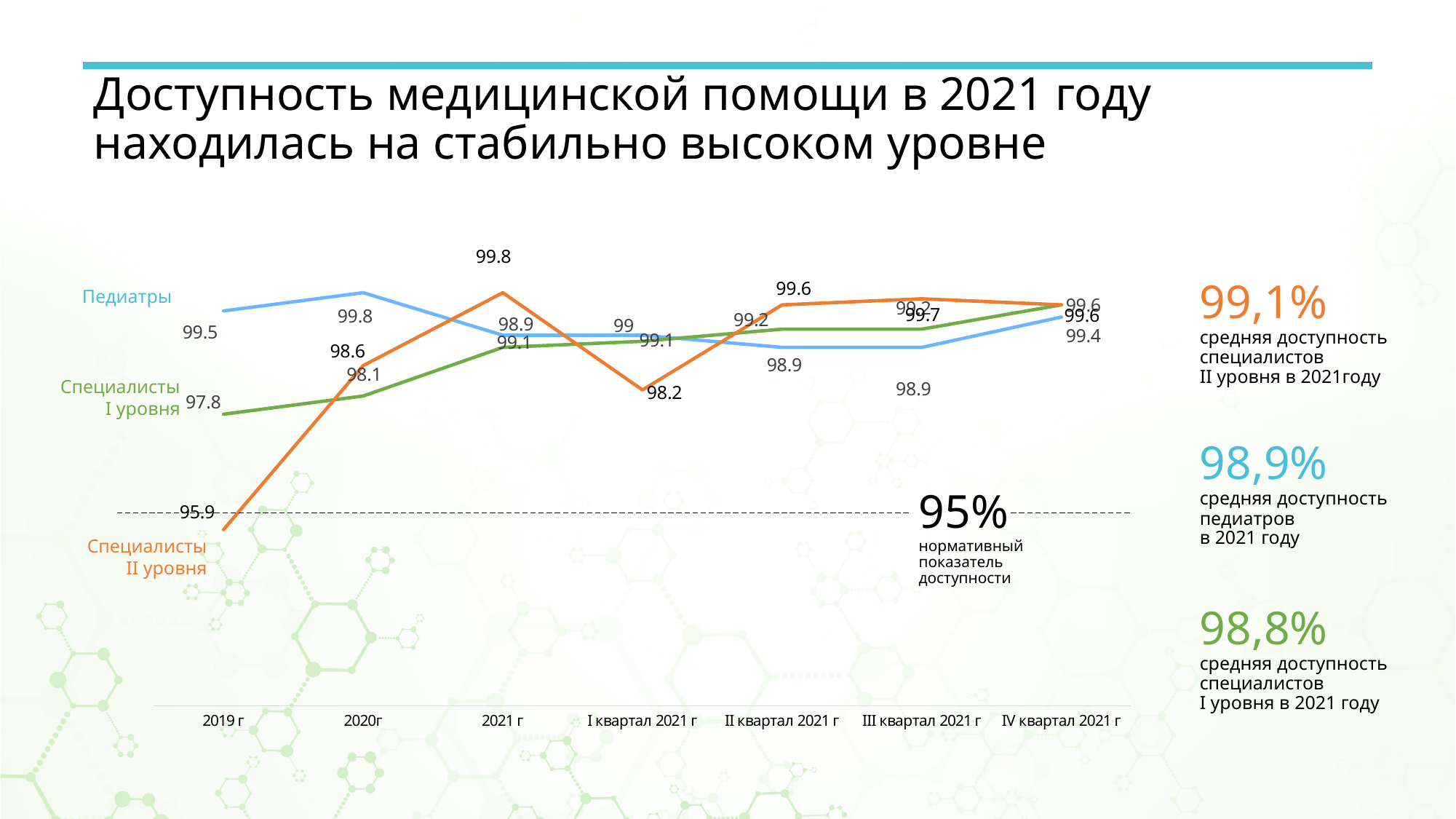
How many categories are shown along the x axis of the chart? 7 What is the value for Специалисты I уровня in 2019 г? 97.8 What value does the dashed horizontal line labelled 'нормативный показатель доступности' mark? 95% What is the difference between the Специалисты II уровня values in 2020г and 2019 г? 2.7 What kind of chart is shown on the slide? line chart What is the value for Специалисты II уровня in I квартал 2021 г? 98.2 What is the value for Специалисты II уровня in 2019 г? 95.9 In which category does the Специалисты II уровня series reach its highest value? 2021 г What is the value for Педиатры in 2019 г? 99.5 In 2019 г, which is higher: Педиатры or Специалисты II уровня? Педиатры How many data series are plotted on the chart? 3 In which category does the Специалисты II уровня series have its lowest value? 2019 г